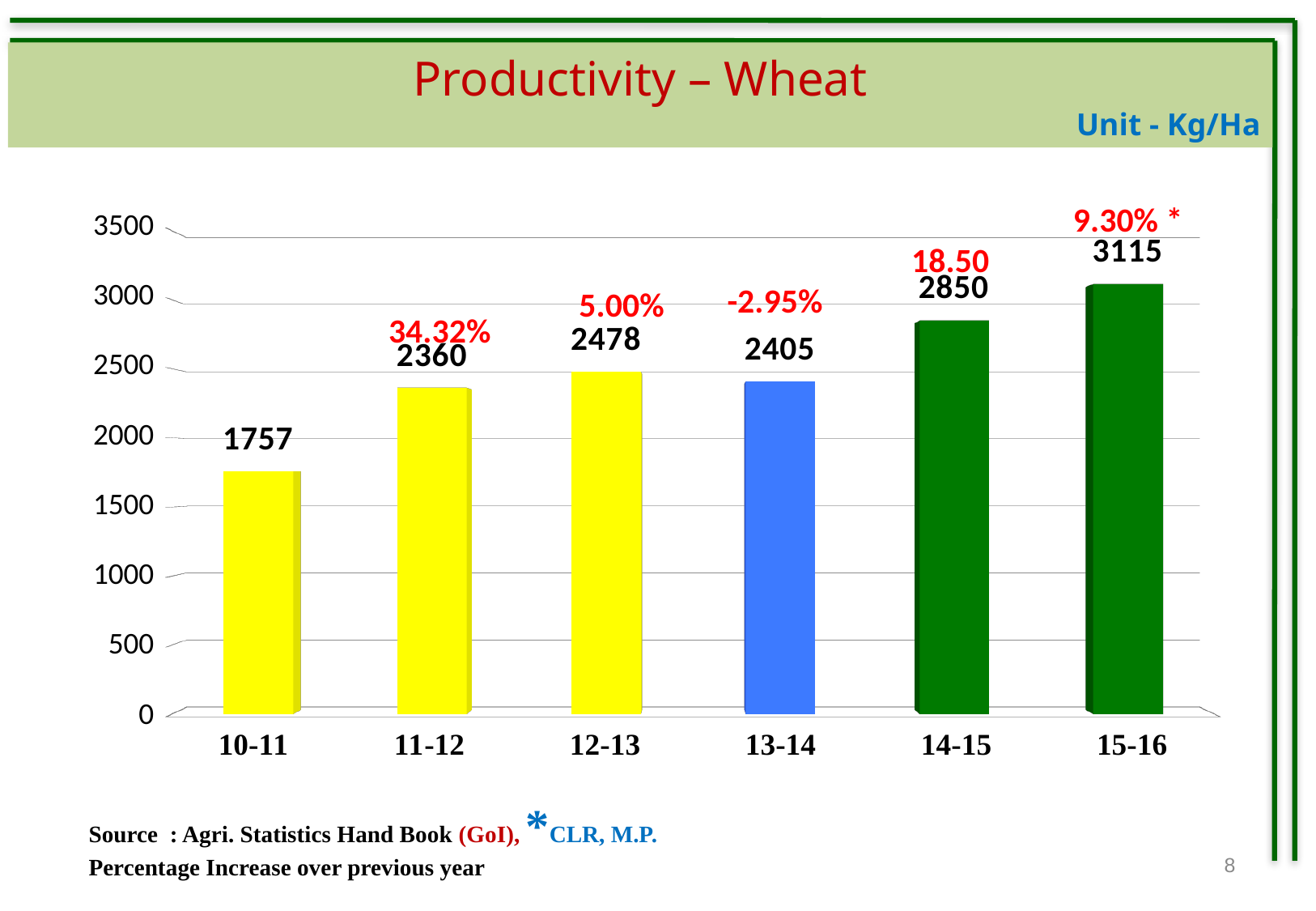
What is the difference in wheat productivity between 15-16 and 14-15? 265 What is the wheat productivity value for 10-11? 1757 What is the wheat productivity value for 15-16? 3115 What percentage increase over the previous year is shown for 14-15? 18.50 What is the difference in wheat productivity between 11-12 and 10-11? 603 Which year has the highest wheat productivity? 15-16 Which year has higher wheat productivity, 12-13 or 13-14? 12-13 How many years are shown on the x axis of the chart? 6 Which year has the lowest wheat productivity? 10-11 What kind of chart is shown on the slide? bar chart Is the wheat productivity value for 14-15 greater or less than 3000? less What is the wheat productivity value for 13-14? 2405